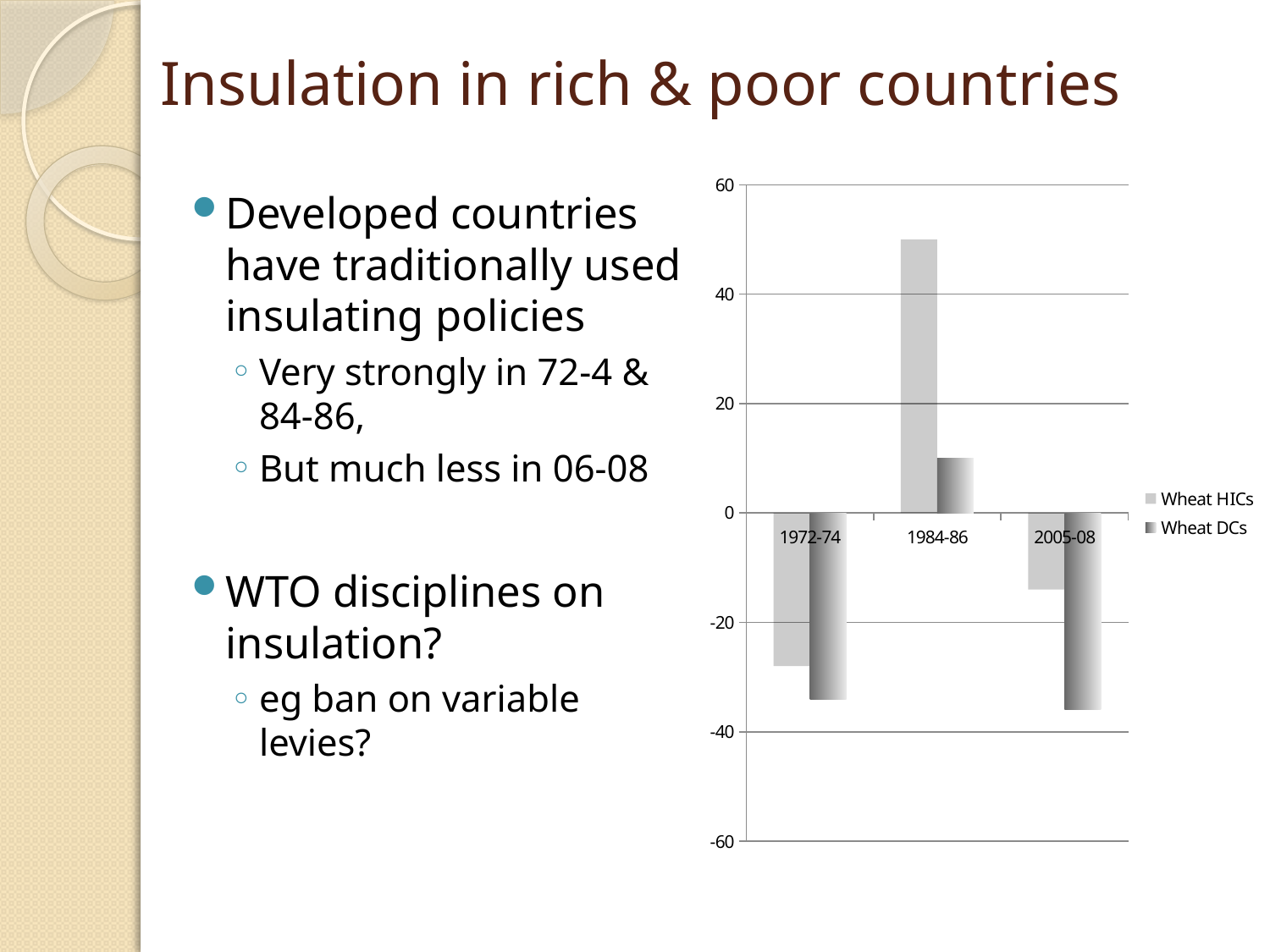
What are the two series named in the chart legend? Wheat HICs and Wheat DCs Which period has the lowest value for Wheat HICs? 1972-74 Is the value for Wheat HICs in 2005-08 greater or less than -20? greater What kind of chart is shown on the slide? bar chart How many series does the chart legend list? 2 Is the value for Wheat DCs in 1984-86 greater or less than 20? less How many categories are shown on the x axis of the chart? 3 In 2005-08, which series has the larger value, Wheat HICs or Wheat DCs? Wheat HICs Is the value for Wheat HICs in 1984-86 greater or less than 40? greater In 1984-86, which series has the larger value, Wheat HICs or Wheat DCs? Wheat HICs Which period has the highest value for Wheat HICs? 1984-86